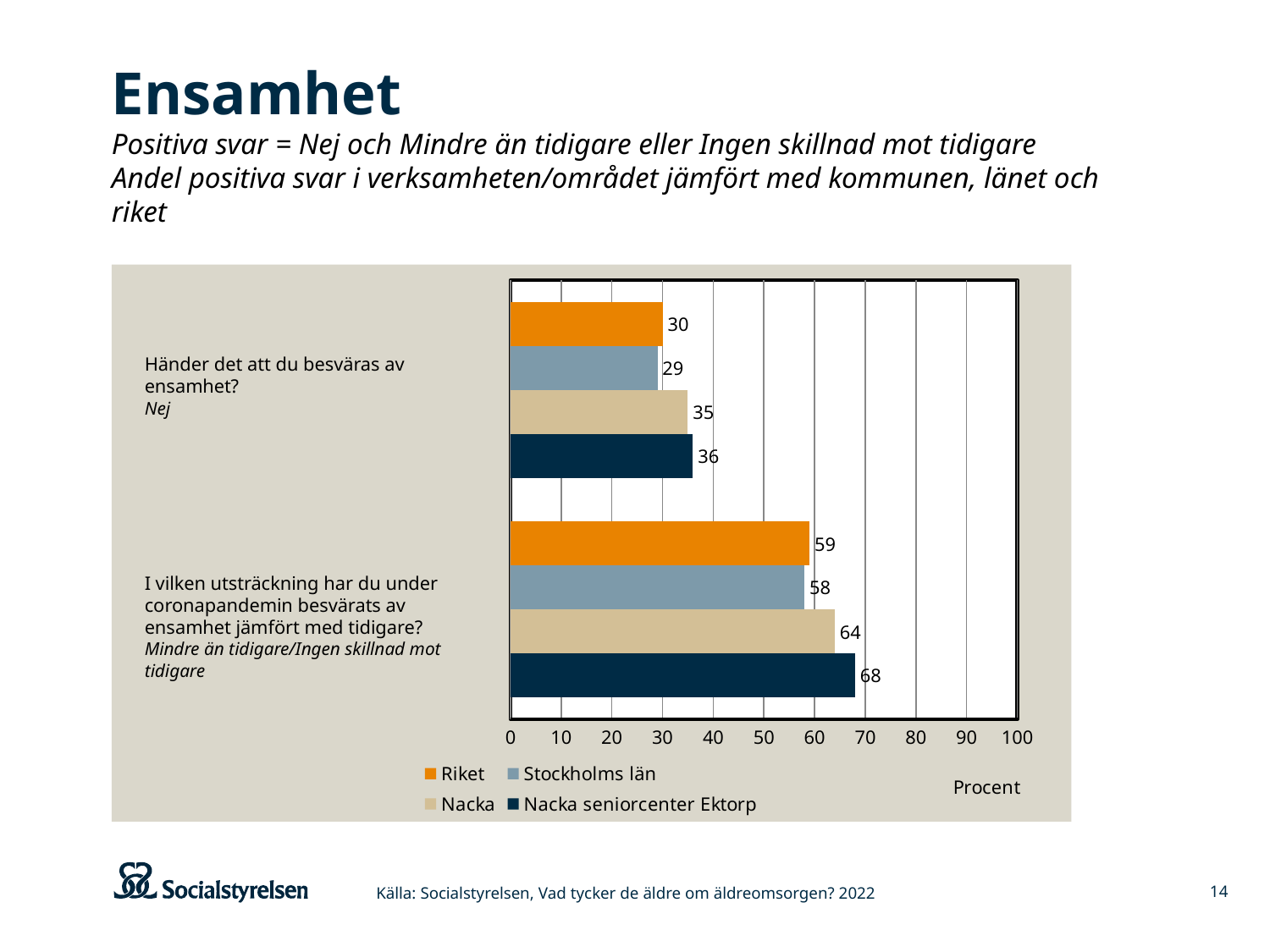
What is the difference between Nacka seniorcenter Ektorp and Riket on the question 'I vilken utsträckning har du under coronapandemin besvärats av ensamhet jämfört med tidigare?' 9 Is the value for Nacka on the question 'I vilken utsträckning har du under coronapandemin besvärats av ensamhet jämfört med tidigare?' greater or less than 50? greater What is the value for Riket on the question 'I vilken utsträckning har du under coronapandemin besvärats av ensamhet jämfört med tidigare?' 59 What unit is shown on the x axis of the chart? Procent How many questions (categories) are shown on the chart? 2 What kind of chart is shown on the slide? Bar chart How many series does the legend list? 4 Which is larger on the question 'Händer det att du besväras av ensamhet?': Nacka or Riket? Nacka Which series has the lowest value on the question 'Händer det att du besväras av ensamhet?' Stockholms län What is the value for Nacka seniorcenter Ektorp on the question 'Händer det att du besväras av ensamhet?' 36 What is the value for Stockholms län on the question 'Händer det att du besväras av ensamhet?' 29 Which series has the highest value on the question 'I vilken utsträckning har du under coronapandemin besvärats av ensamhet jämfört med tidigare?' Nacka seniorcenter Ektorp